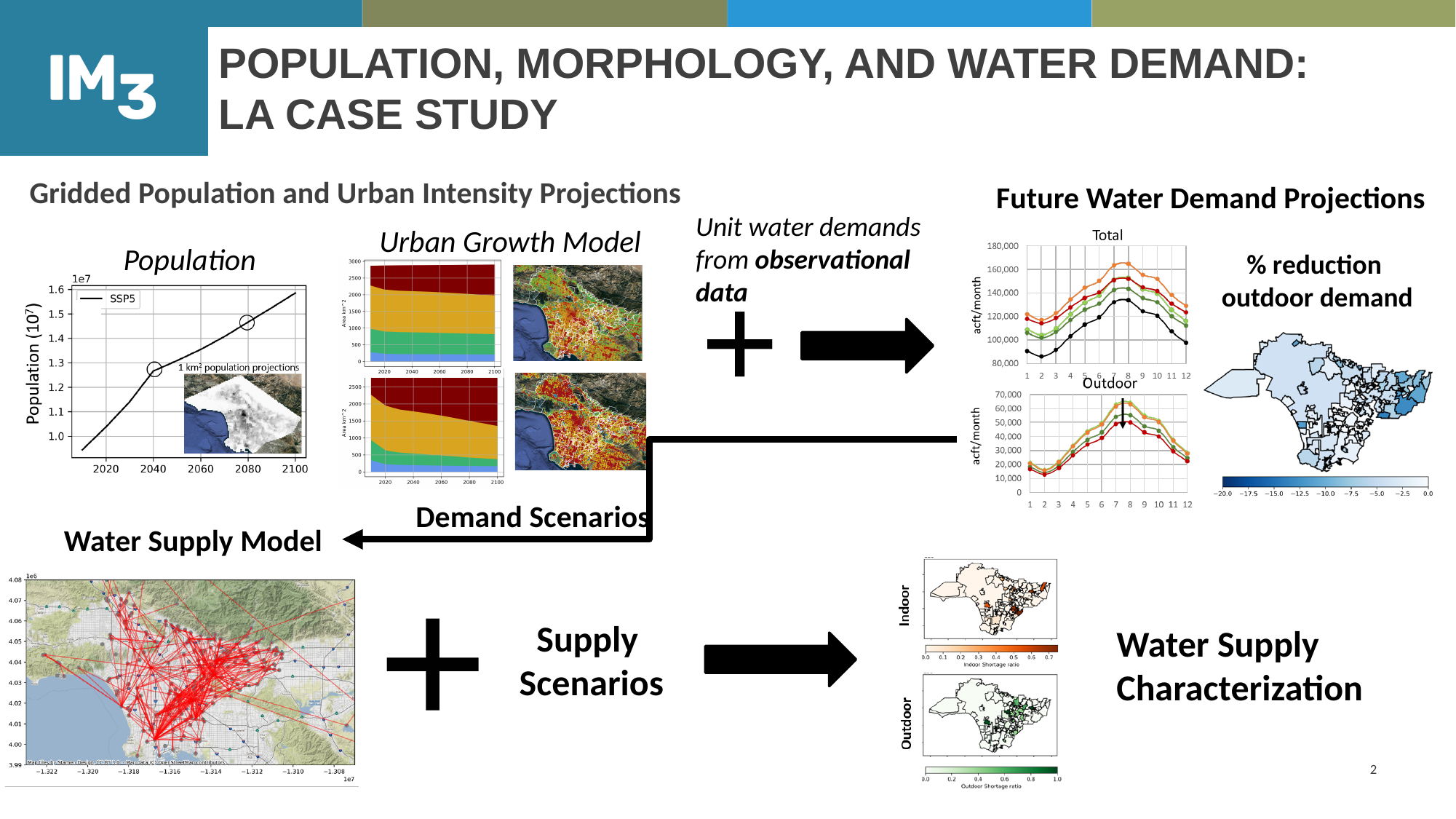
What is the name of the series shown in the Population chart legend? SSP5 In the Total water demand chart, how many months are plotted on the x axis? 12 In the Population chart, is the value for 2020 greater or less than 1.1? less In the Outdoor water demand chart, is the value of the highest series at month 8 greater or less than 60,000? greater How many series does the legend of the Population chart list? 1 In the Population chart, is the value for 2100 greater or less than 1.5? greater In the Total water demand chart, which month has the highest demand? 8 In the Population chart, does the population rise or fall from 2020 to 2100? rise What kind of chart are the two Urban Growth Model charts? stacked area chart What kind of chart is the Population chart? line chart What unit is shown on the y axis of the Total and Outdoor water demand charts? acft/month